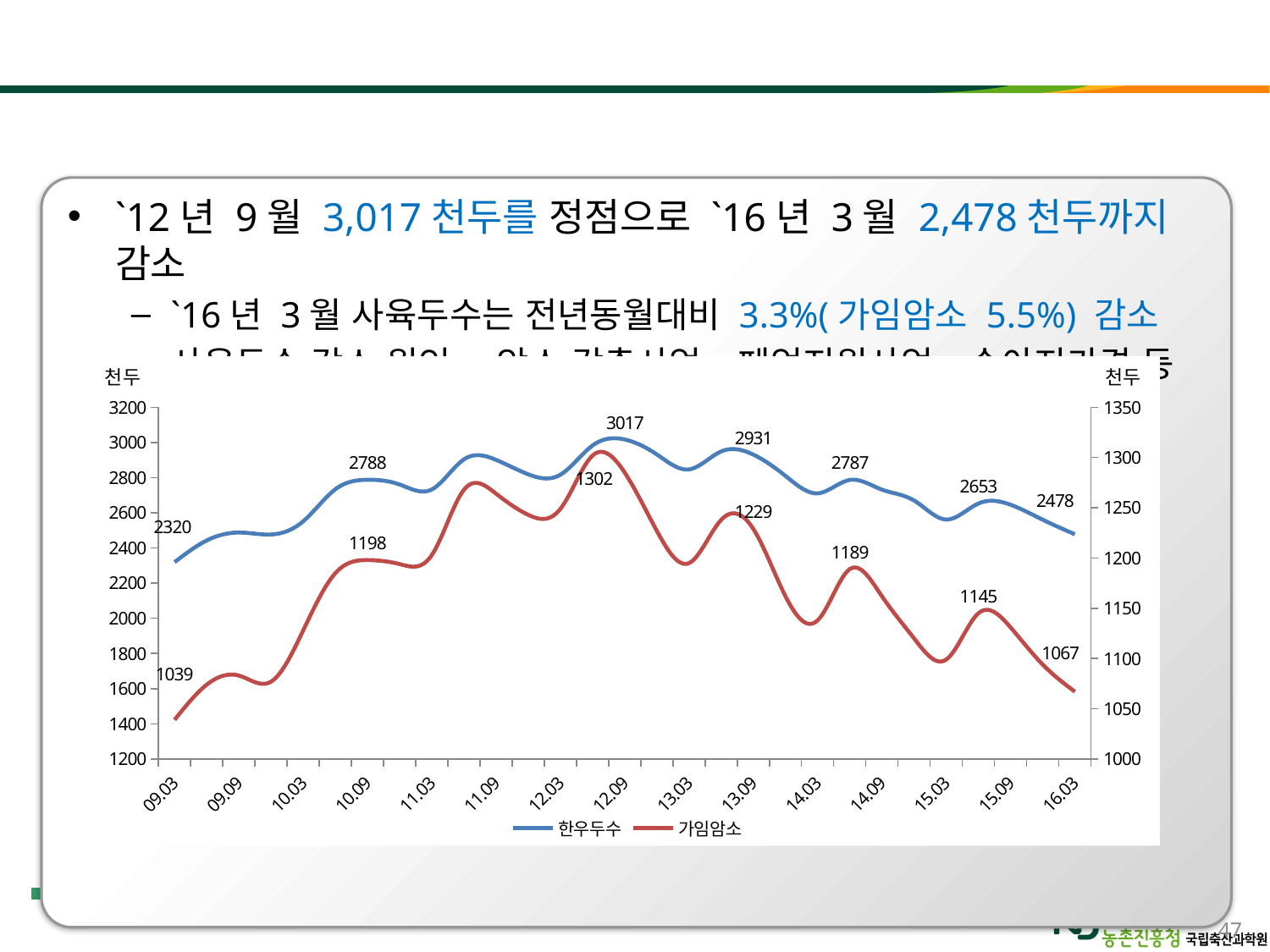
Which is larger, the 가임암소 value at 13.09 or at 14.09? 13.09 What type of chart is shown on the slide? line chart At which x-axis point does 한우두수 reach its highest labelled value? 12.09 How many series does the chart legend list? 2 What is the value of 한우두수 at 09.03? 2320 What is the difference between the 한우두수 values at 12.09 and 16.03? 539 At which x-axis point does 가임암소 have its lowest labelled value? 09.03 What is the value of 가임암소 at 16.03? 1067 Does 한우두수 rise or fall from 12.09 to 16.03? fall What is the value of 한우두수 at 12.09? 3017 How many x-axis points are shown on the chart? 15